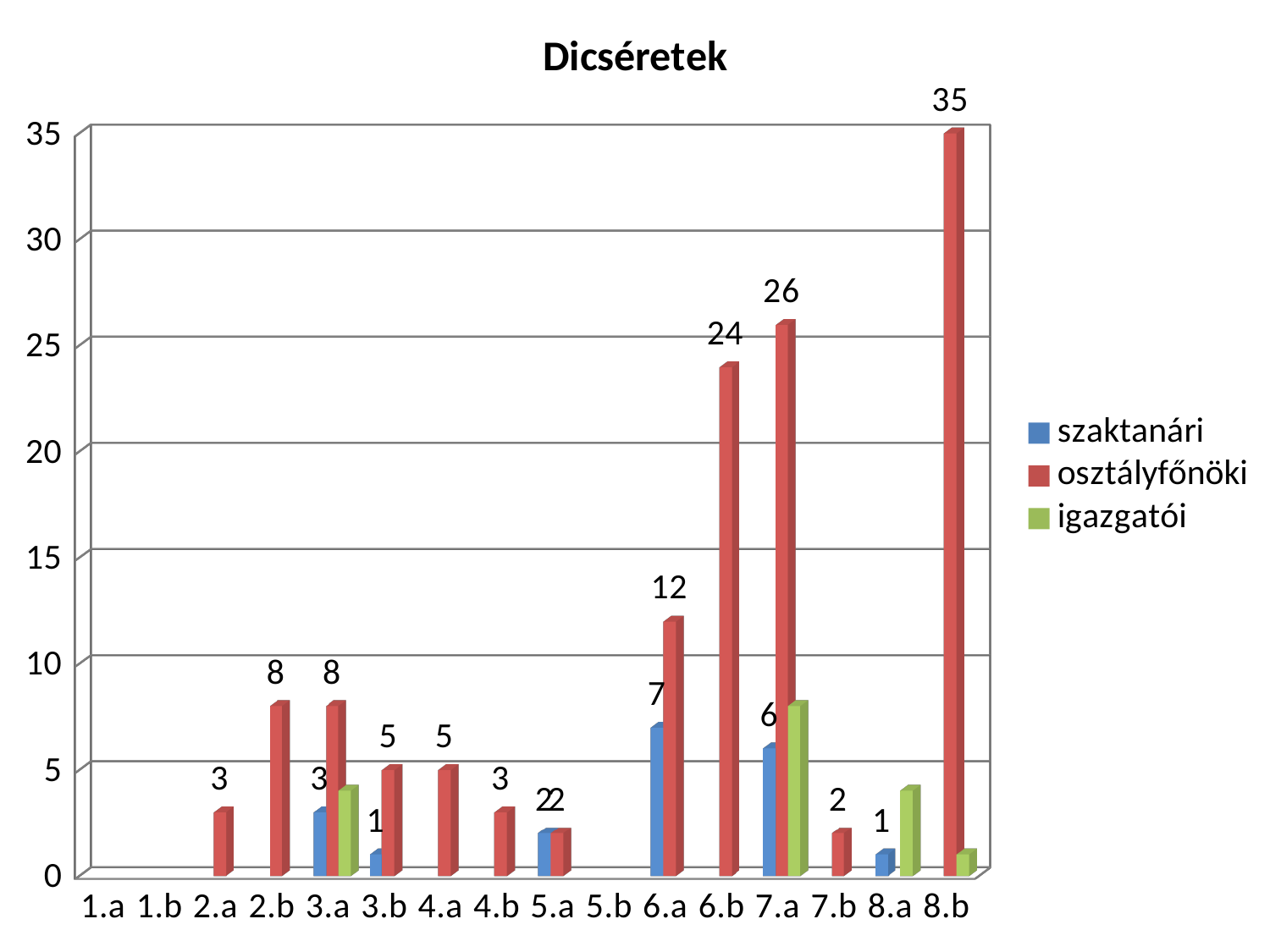
What is the difference between the osztályfőnöki values for 7.a and 6.a? 14 What is the szaktanári value for class 6.a? 7 What is the osztályfőnöki value for class 8.b? 35 What kind of chart is shown? bar chart What is the title of the chart? Dicséretek Is the igazgatói value for class 8.b greater or less than 5? less Which class has the highest osztályfőnöki value? 8.b How many classes are shown on the x axis? 16 Which is larger, the osztályfőnöki value for 2.b or for 3.b? 2.b What is the osztályfőnöki value for class 6.b? 24 Is the igazgatói value for class 7.a greater or less than 5? greater How many series does the legend list? 3